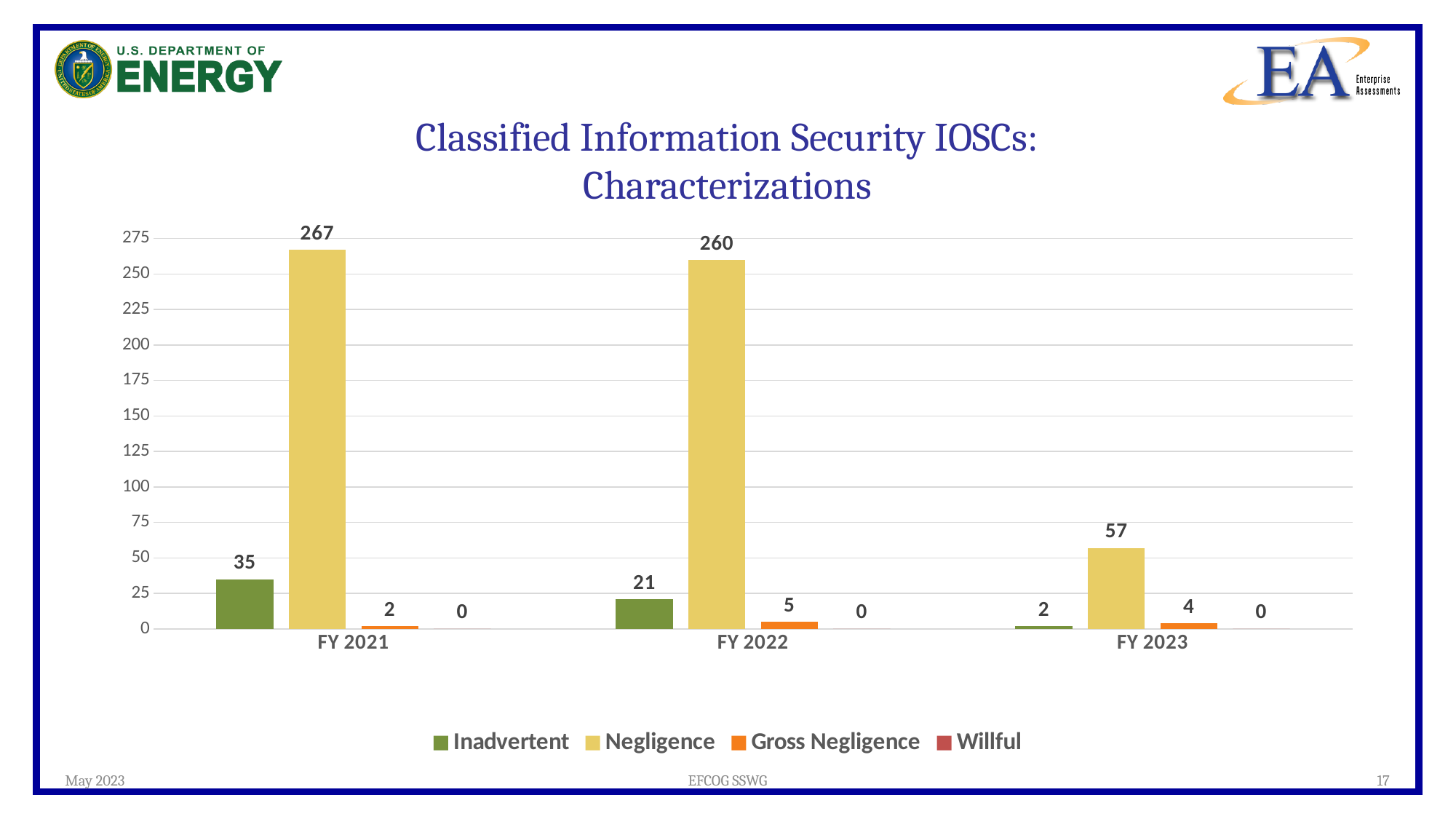
What is the Willful value for FY 2022? 0 What kind of chart is shown on the slide? Bar chart Does the Negligence value rise or fall from FY 2021 to FY 2023? Fall Which is larger, the Gross Negligence value for FY 2022 or for FY 2021? FY 2022 What is the Negligence value for FY 2021? 267 What is the difference between the Negligence values for FY 2022 and FY 2023? 203 Which fiscal year has the lowest Inadvertent value? FY 2023 Which fiscal year has the highest Negligence value? FY 2021 What is the Inadvertent value for FY 2022? 21 What is the Gross Negligence value for FY 2023? 4 How many series does the legend list? 4 How many fiscal years are shown on the x axis? 3